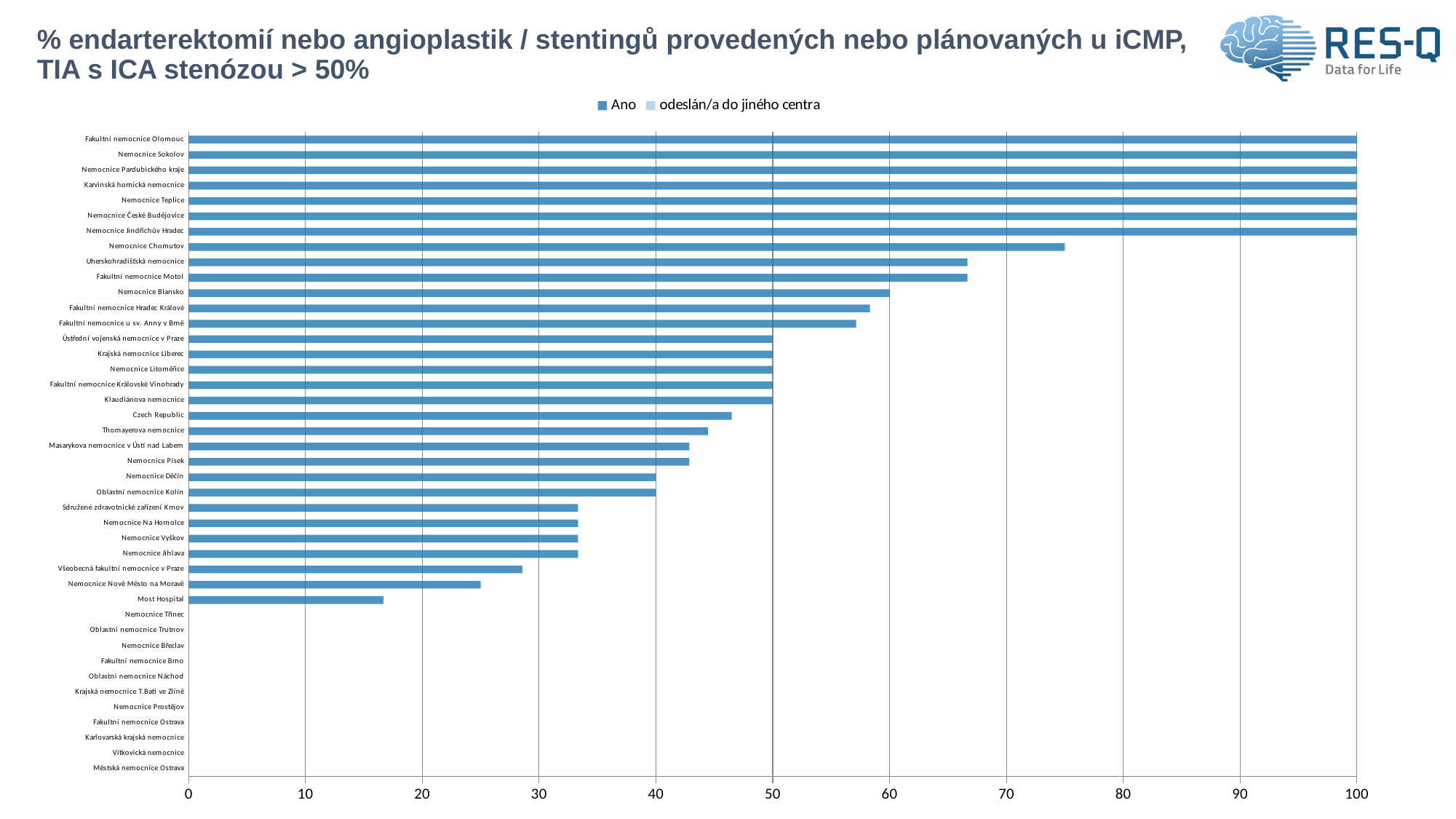
How many hospitals (categories) are listed on the vertical axis? 42 What is the value for Nemocnice Blansko? 60 What kind of chart is shown on the slide? bar chart What is the value for Nemocnice Děčín? 40 What is the difference between the values for Nemocnice Blansko and Nemocnice Děčín? 20 Is the value for Most Hospital greater or less than 20? less What is the value for Krajská nemocnice Liberec? 50 Which is larger, the value for Nemocnice Chomutov or the value for Fakultní nemocnice Motol? Nemocnice Chomutov What is the value for Fakultní nemocnice Olomouc? 100 What are the two series named in the legend? Ano; odeslán/a do jiného centra Is the value for Nemocnice Chomutov greater or less than 70? greater How many series does the legend list? 2